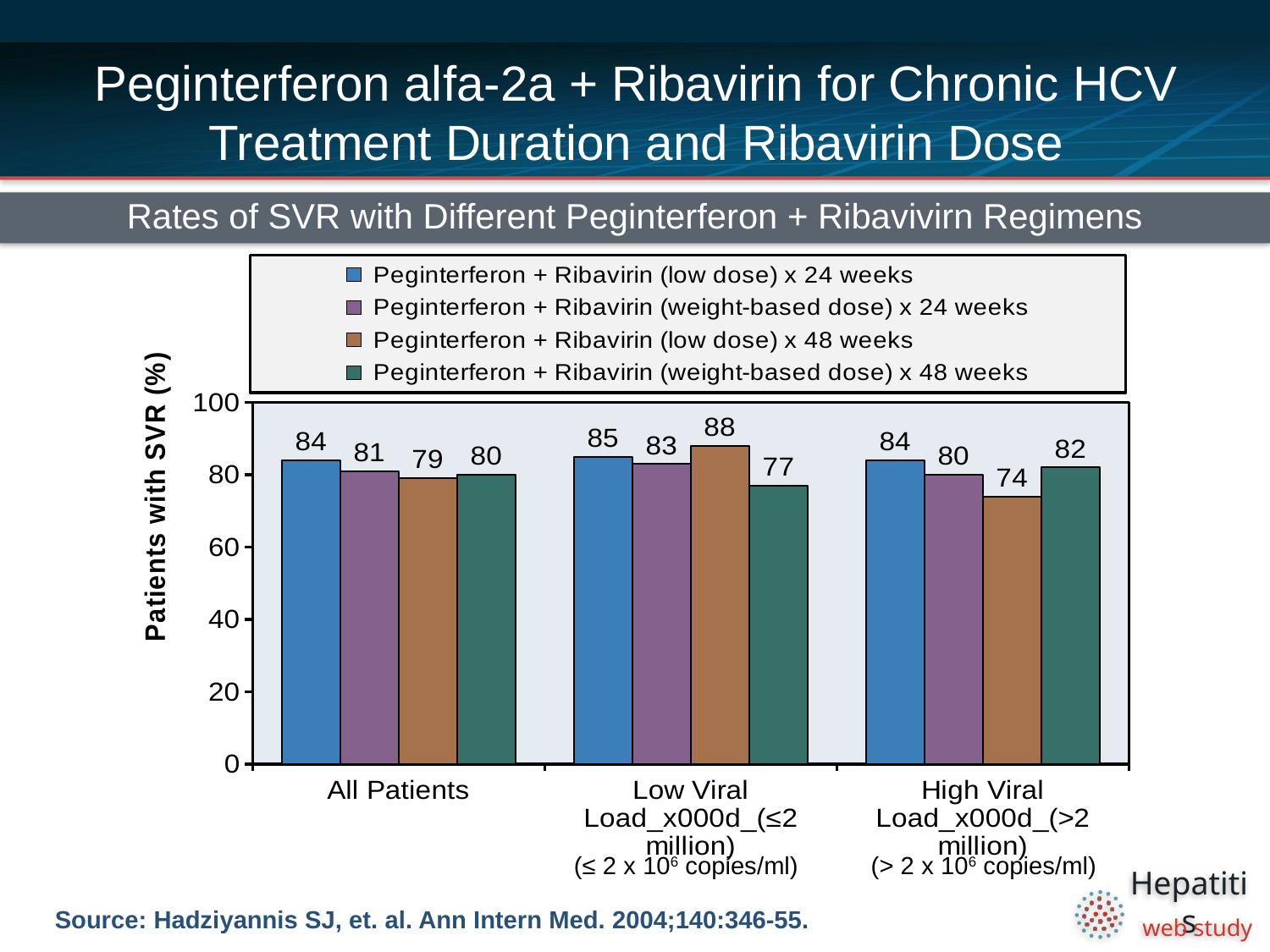
What is the label of the y axis of the chart? Patients with SVR (%) Which regimen has the highest SVR rate in the Low Viral Load group? Peginterferon + Ribavirin (low dose) x 48 weeks Is the SVR rate for Peginterferon + Ribavirin (weight-based dose) x 48 weeks in the Low Viral Load group greater or less than 80? less What is the SVR rate for Peginterferon + Ribavirin (low dose) x 48 weeks in the High Viral Load group? 74 In the High Viral Load group, which has the higher SVR rate: Peginterferon + Ribavirin (low dose) x 24 weeks or Peginterferon + Ribavirin (low dose) x 48 weeks? Peginterferon + Ribavirin (low dose) x 24 weeks How many patient groups are shown on the x axis of the chart? 3 How many regimens does the legend list? 4 What is the SVR rate for Peginterferon + Ribavirin (low dose) x 48 weeks in the Low Viral Load group? 88 What is the difference between the SVR rates for Peginterferon + Ribavirin (low dose) x 48 weeks and Peginterferon + Ribavirin (weight-based dose) x 48 weeks in the Low Viral Load group? 11 Which regimen has the lowest SVR rate in the High Viral Load group? Peginterferon + Ribavirin (low dose) x 48 weeks What is the SVR rate for Peginterferon + Ribavirin (weight-based dose) x 24 weeks among All Patients? 81 What type of chart is shown on the slide? Bar chart